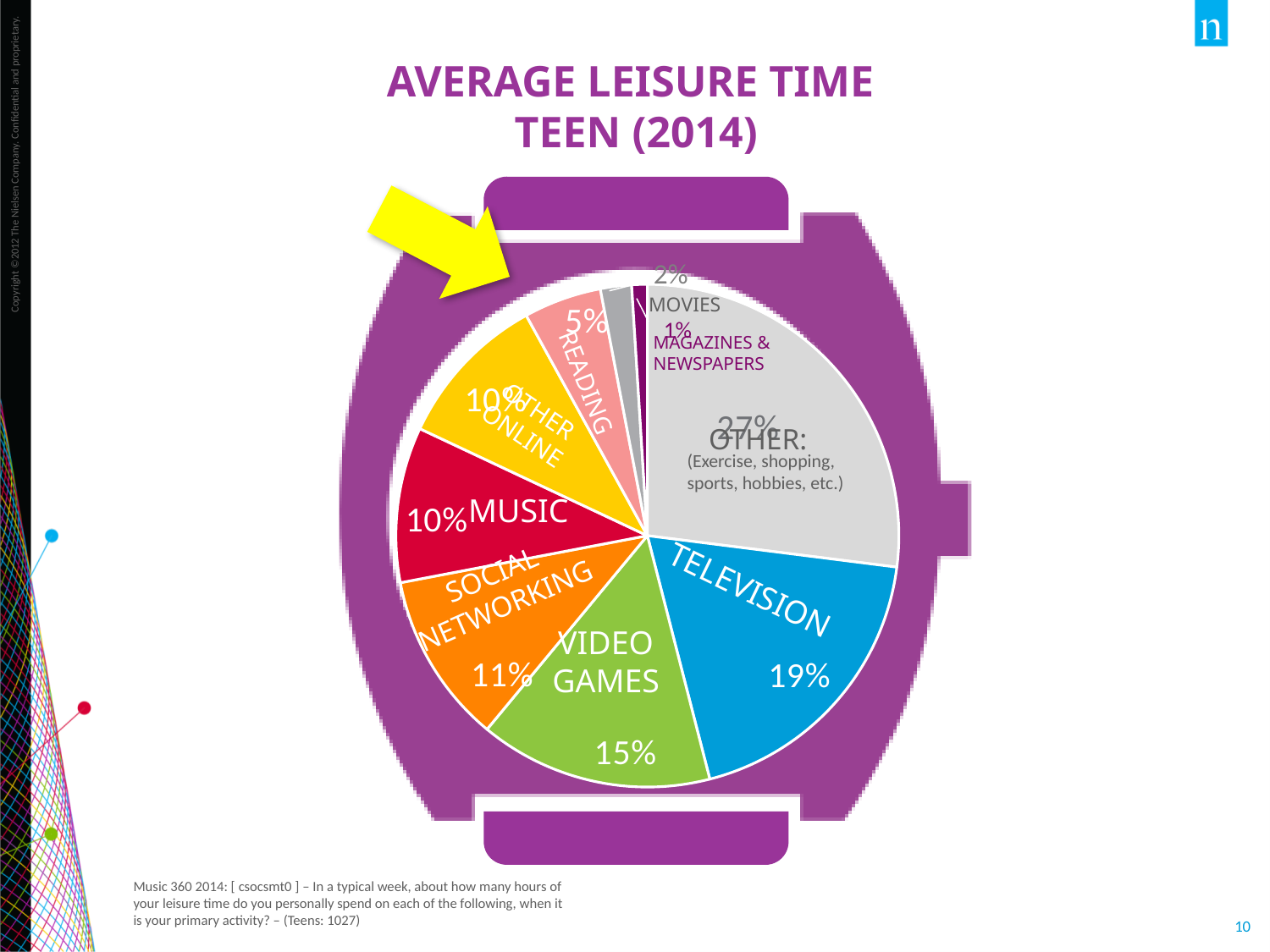
What share of leisure time is spent on magazines & newspapers? 1% What share of leisure time is spent on reading? 5% What is the title of the chart? AVERAGE LEISURE TIME TEEN (2014) What is the difference between the television share and the video games share? 4% What share of leisure time is spent on social networking? 11% Which category has the smallest share of leisure time? MAGAZINES & NEWSPAPERS What kind of chart is shown on the slide? pie chart How many slices does the pie chart have? 9 What share of leisure time is spent on video games? 15% What share of leisure time is spent on television? 19% What share of leisure time is spent on music? 10% Which category has the largest share of leisure time? OTHER (Exercise, shopping, sports, hobbies, etc.)